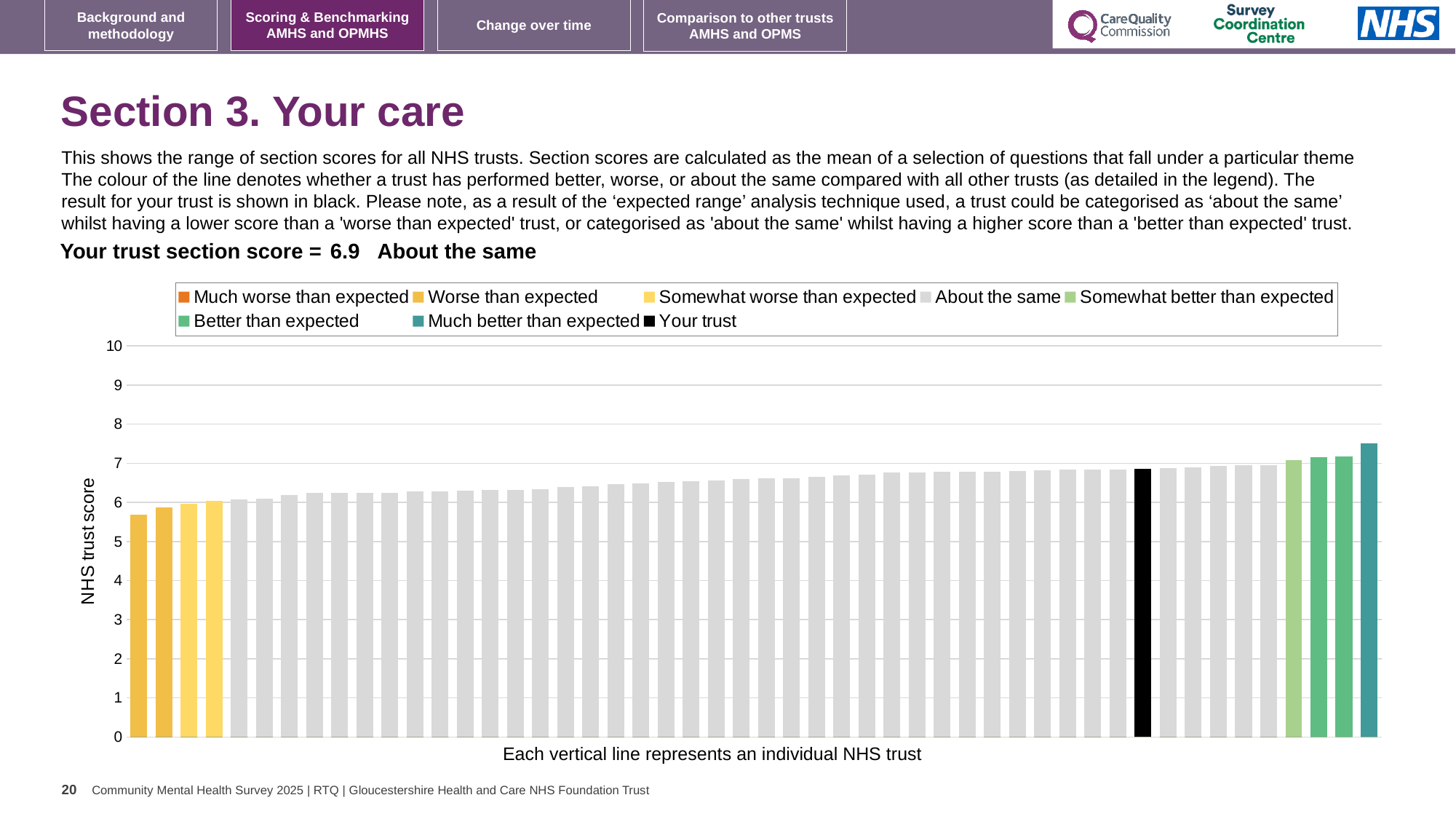
Do the bar values rise or fall from left to right along the x axis? rise How many bars are coloured as 'Much better than expected' (teal)? 1 Is the value of the lowest bar in the chart greater or less than 6? less Is the value of the highest bar in the chart greater or less than 7? greater What is the section score for your trust shown on the slide? 6.9 What colour is the bar representing your trust? black Is the value of the black bar (your trust) greater or less than 5? greater What kind of chart is shown on the slide? bar chart What is the title of the vertical axis? NHS trust score How many entries does the chart legend list? 8 Which performance category is your trust placed in for Section 3. Your care? About the same